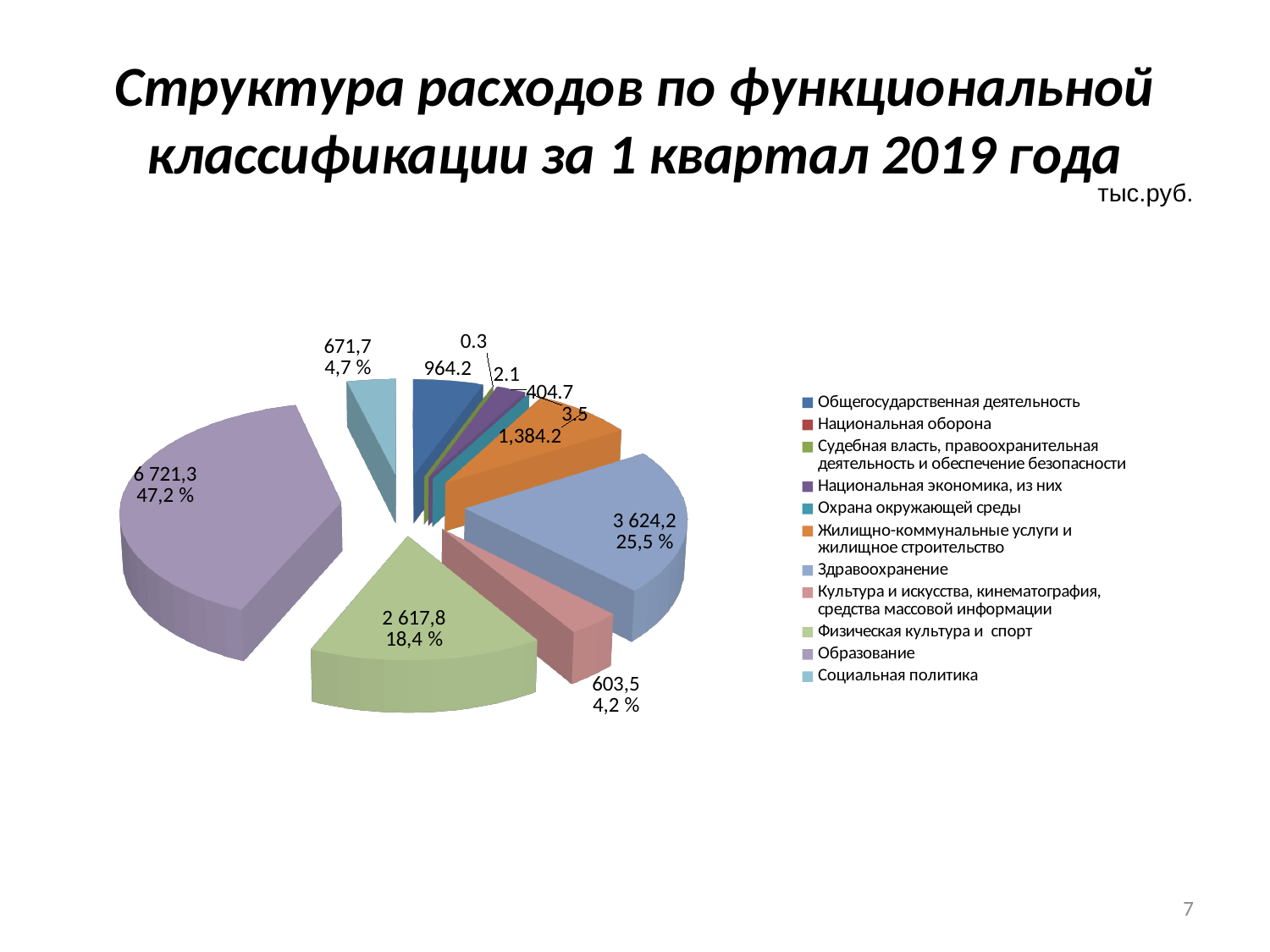
How many categories does the legend of the pie chart list? 11 What is the value shown for Образование? 6 721,3 What kind of chart is shown on the slide? pie chart What is the difference between the values for Образование and Здравоохранение? 3 097,1 Which is larger, the value for Здравоохранение or the value for Физическая культура и спорт? Здравоохранение What is the value shown for Жилищно-коммунальные услуги и жилищное строительство? 1,384.2 Which category has the largest slice of the pie chart? Образование What share of the pie does Здравоохранение account for? 25,5 % What is the value shown for Социальная политика? 671,7 What unit is stated for the values on the slide? тыс.руб. What share of the pie does Образование account for? 47,2 % Which category has the smallest slice of the pie chart? Национальная оборона